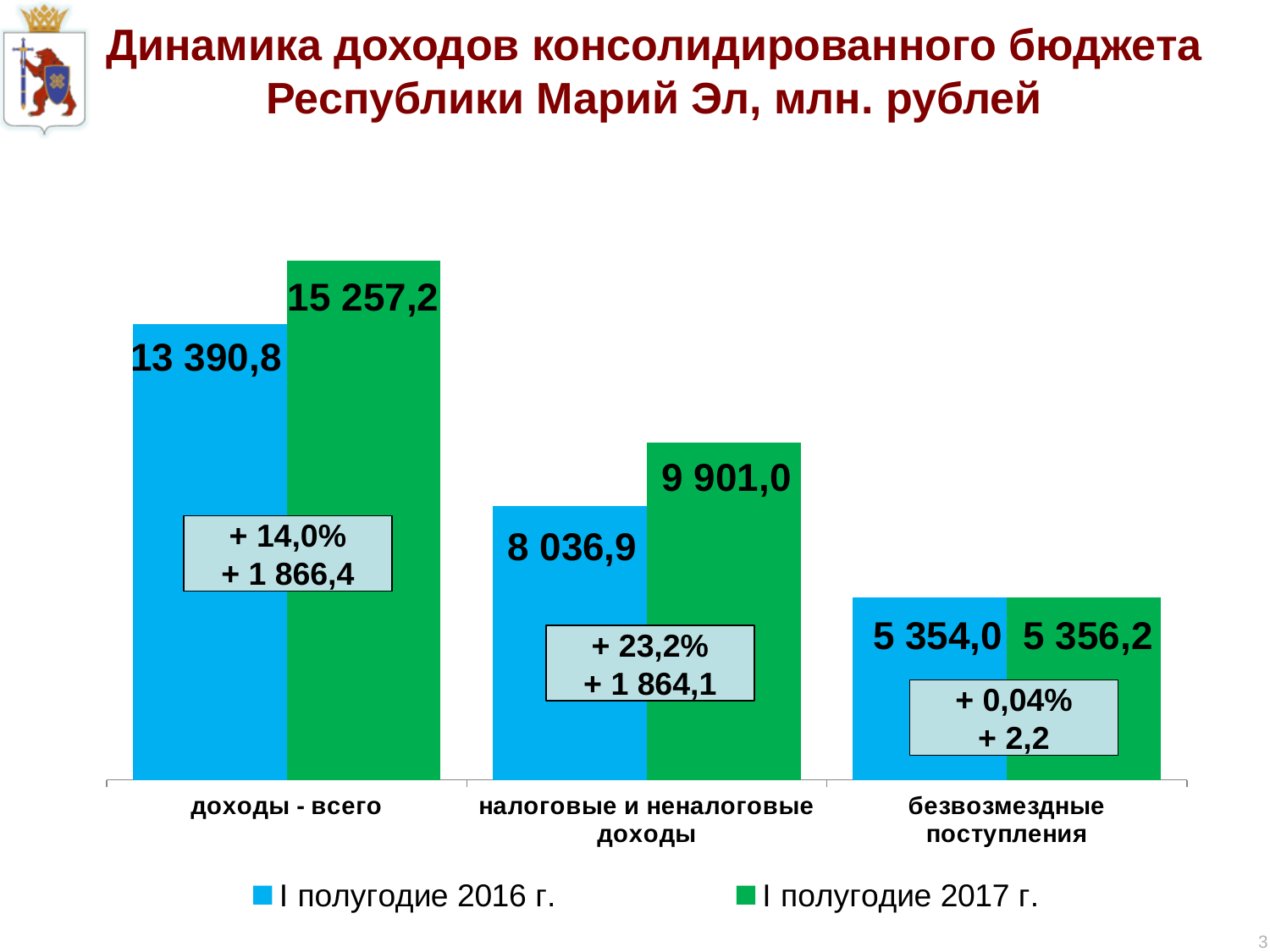
What is the value for «безвозмездные поступления» in I полугодие 2017 г.? 5 356,2 What is the value for «налоговые и неналоговые доходы» in I полугодие 2016 г.? 8 036,9 Which category has the highest value in I полугодие 2016 г.? доходы - всего What kind of chart is shown on the slide? bar chart What percentage growth is shown in the box for «безвозмездные поступления»? + 0,04% How many series does the legend list? 2 Which is larger for «налоговые и неналоговые доходы»: the I полугодие 2016 г. value or the I полугодие 2017 г. value? I полугодие 2017 г. What is the difference between the I полугодие 2017 г. and I полугодие 2016 г. values for «доходы - всего»? 1 866,4 Which category has the lowest value in I полугодие 2017 г.? безвозмездные поступления What is the value for «доходы - всего» in I полугодие 2017 г.? 15 257,2 What is the difference between the I полугодие 2017 г. and I полугодие 2016 г. values for «налоговые и неналоговые доходы»? 1 864,1 How many categories are shown on the x axis? 3